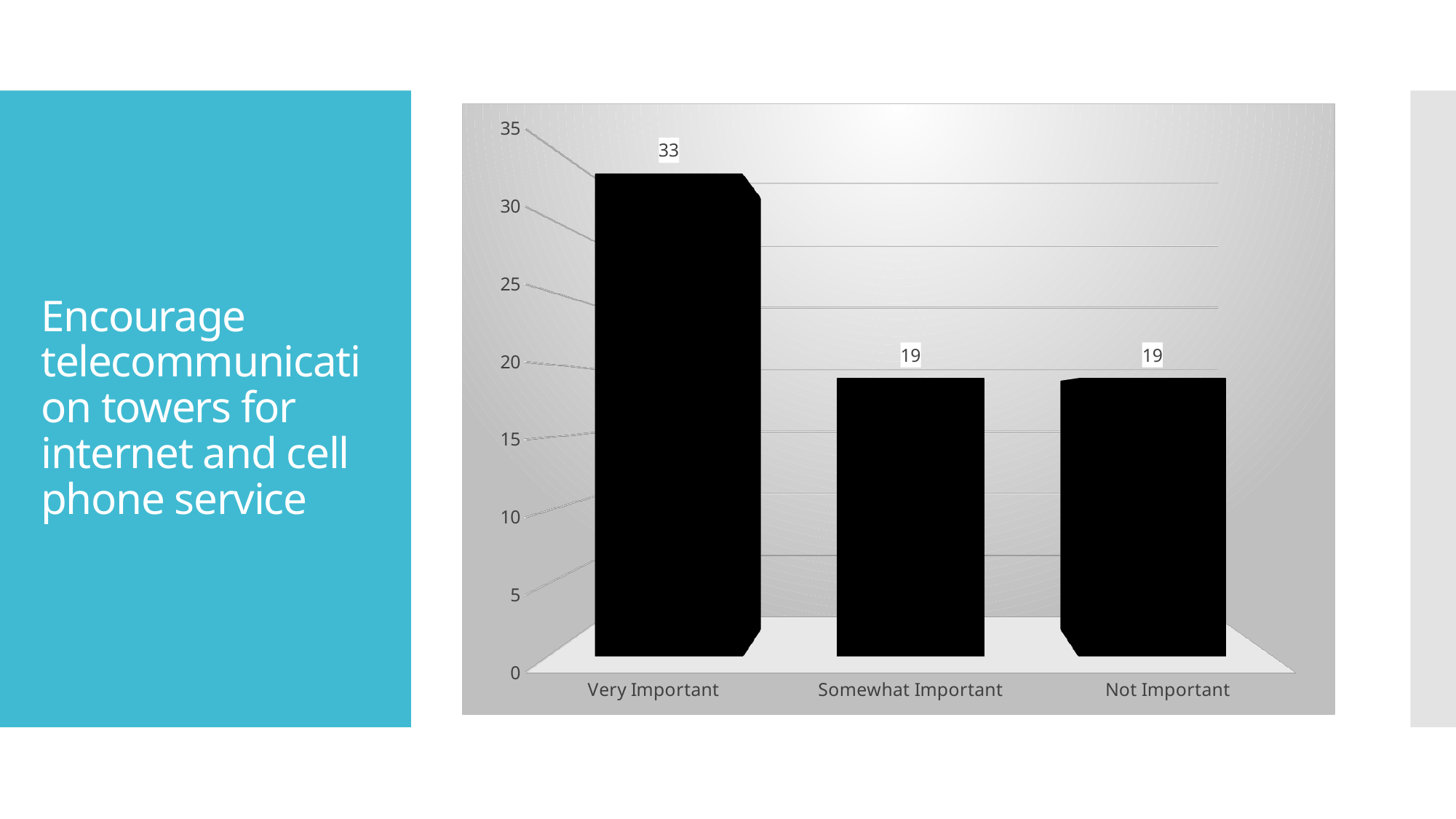
What colour are the bars in the chart? black What kind of chart is shown on the slide? bar chart What is the value for Not Important? 19 What is the value for Somewhat Important? 19 How many categories are shown on the x axis? 3 Which is larger, the value for Very Important or the value for Not Important? Very Important Is the value for Very Important greater or less than 30? greater Do the values rise or fall from Very Important to Somewhat Important? fall What is the value for Very Important? 33 What is the difference between the values for Very Important and Somewhat Important? 14 Is the value for Somewhat Important greater or less than 20? less Which category has the highest value? Very Important